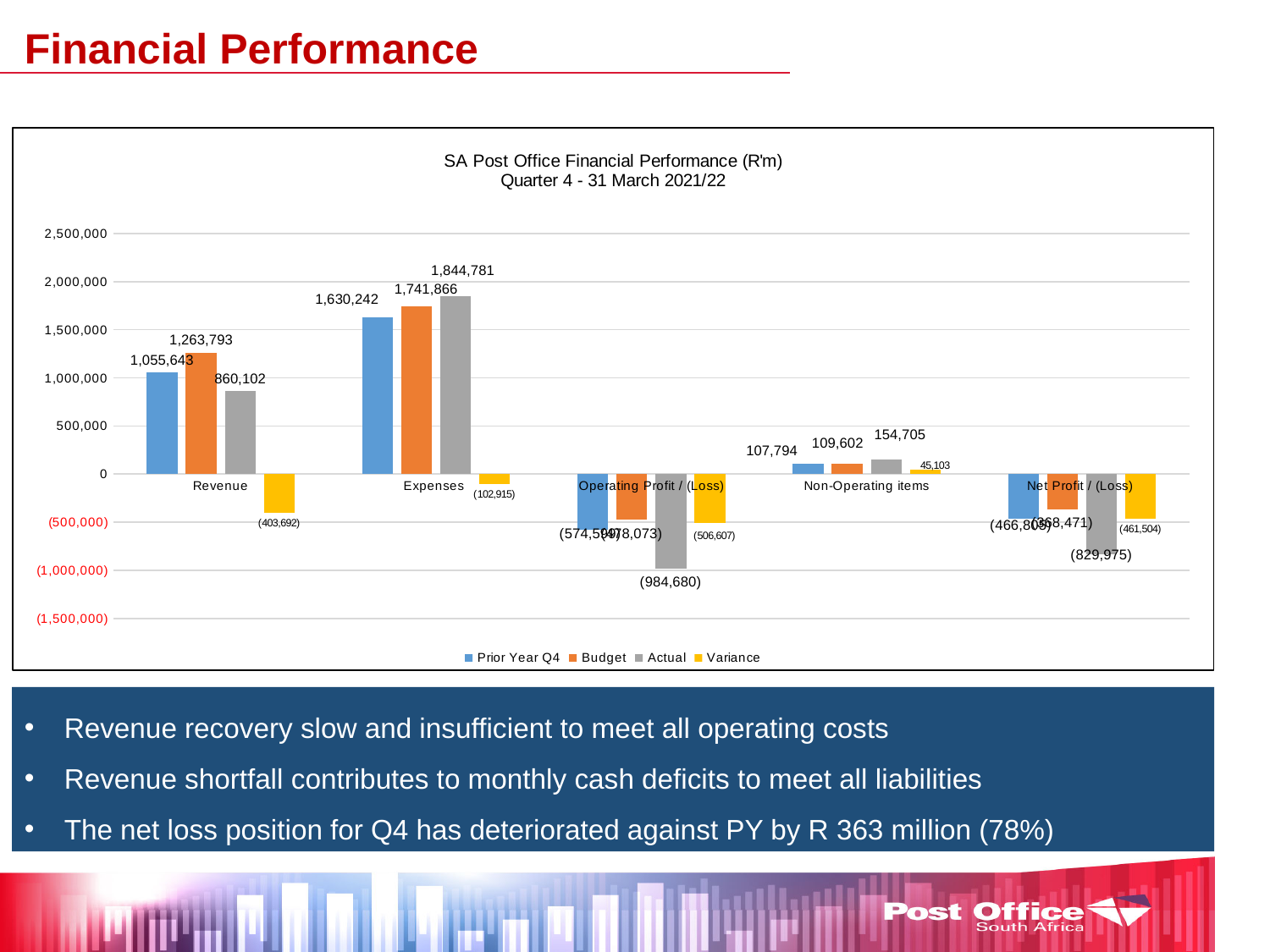
How many categories are shown on the x axis? 5 What is the Budget value for Expenses? 1,741,866 Which series has the highest value for Expenses? Actual What is the difference between the Budget and Prior Year Q4 values for Revenue? 208,150 What is the Variance value for Revenue? (403,692) What is the Actual value for Non-Operating items? 154,705 What is the Actual value for Revenue? 860,102 What is the Actual value for Operating Profit / (Loss)? (984,680) What kind of chart is shown on the slide? Bar chart How many series does the legend list? 4 What is the title of the chart? SA Post Office Financial Performance (R'm) Quarter 4 - 31 March 2021/22 For Revenue, which is larger: the Prior Year Q4 value or the Actual value? Prior Year Q4